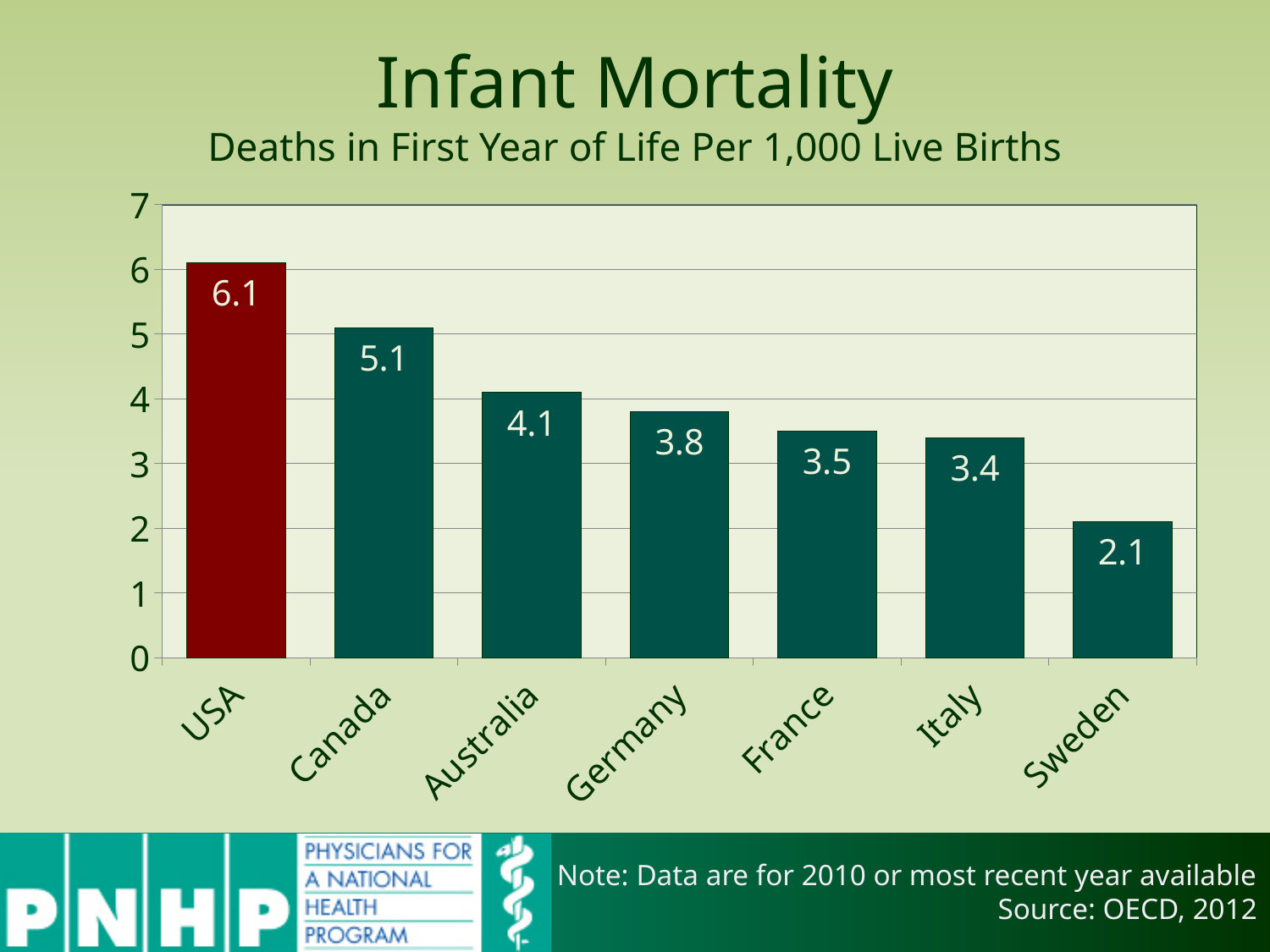
What kind of chart is shown on the slide? Bar chart Which has a higher infant mortality rate, France or Italy? France What is the infant mortality rate for the USA? 6.1 What is the infant mortality rate for Germany? 3.8 What is the difference between the infant mortality rates of the USA and Canada? 1.0 Which country has the highest infant mortality rate on the chart? USA Which bar is coloured differently from the others? USA Which country has the lowest infant mortality rate on the chart? Sweden How many countries are shown on the chart? 7 What is the difference between the infant mortality rates of Australia and Sweden? 2.0 Is the value for Canada greater or less than 5? greater What is the infant mortality rate for Sweden? 2.1